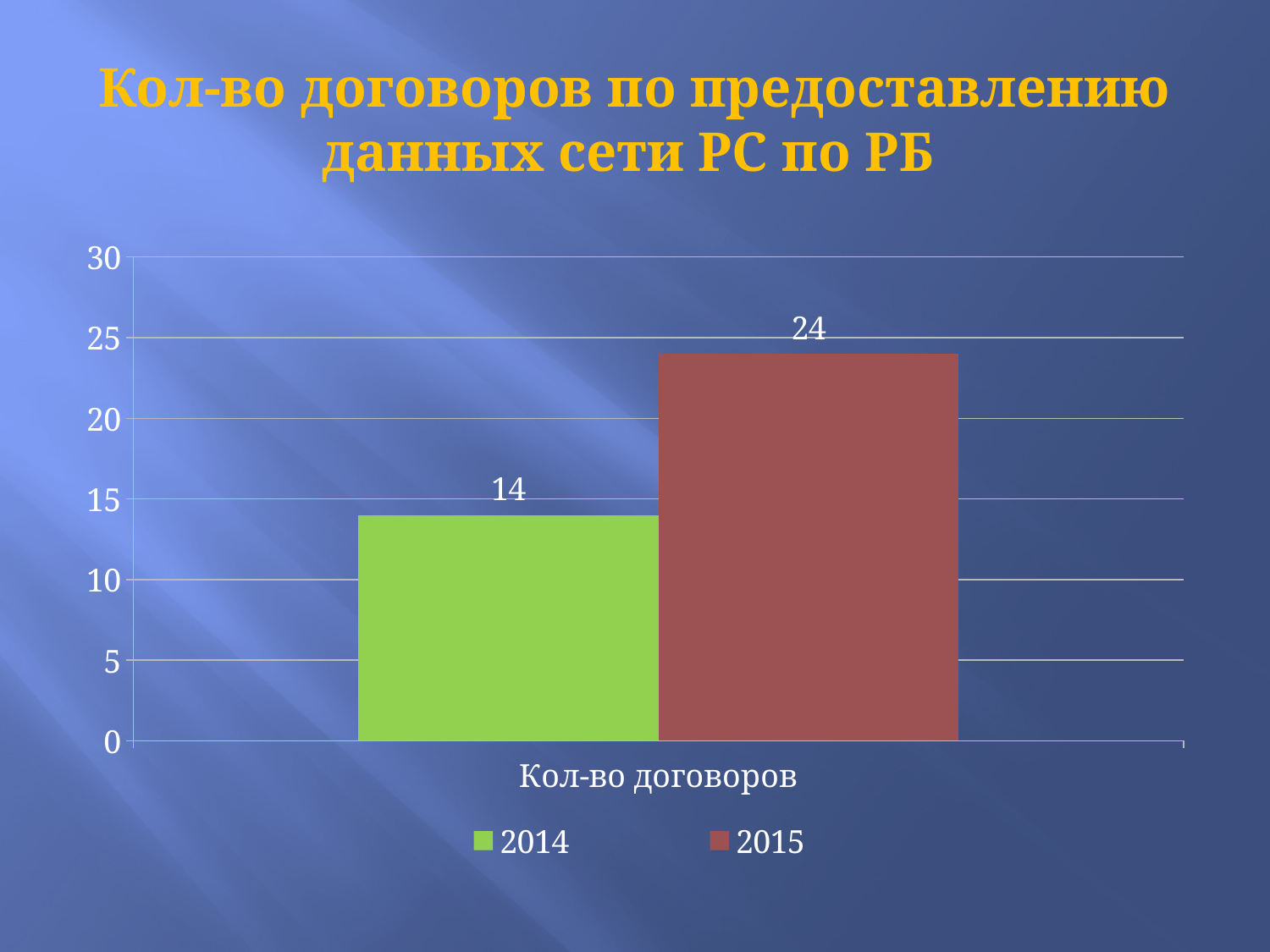
What is the value for 2015 in the chart? 24 What kind of chart is shown on the slide? bar chart Which series has the lowest value? 2014 What is the value for 2014 in the chart? 14 Which series has the higher value, 2014 or 2015? 2015 What is the difference between the 2015 and 2014 values? 10 Is the value for 2015 greater or less than 20? greater What colour is the bar for 2015? red Which series has the highest value? 2015 What is the category label shown on the x axis? Кол-во договоров Is the value for 2014 greater or less than 15? less How many series does the legend list? 2